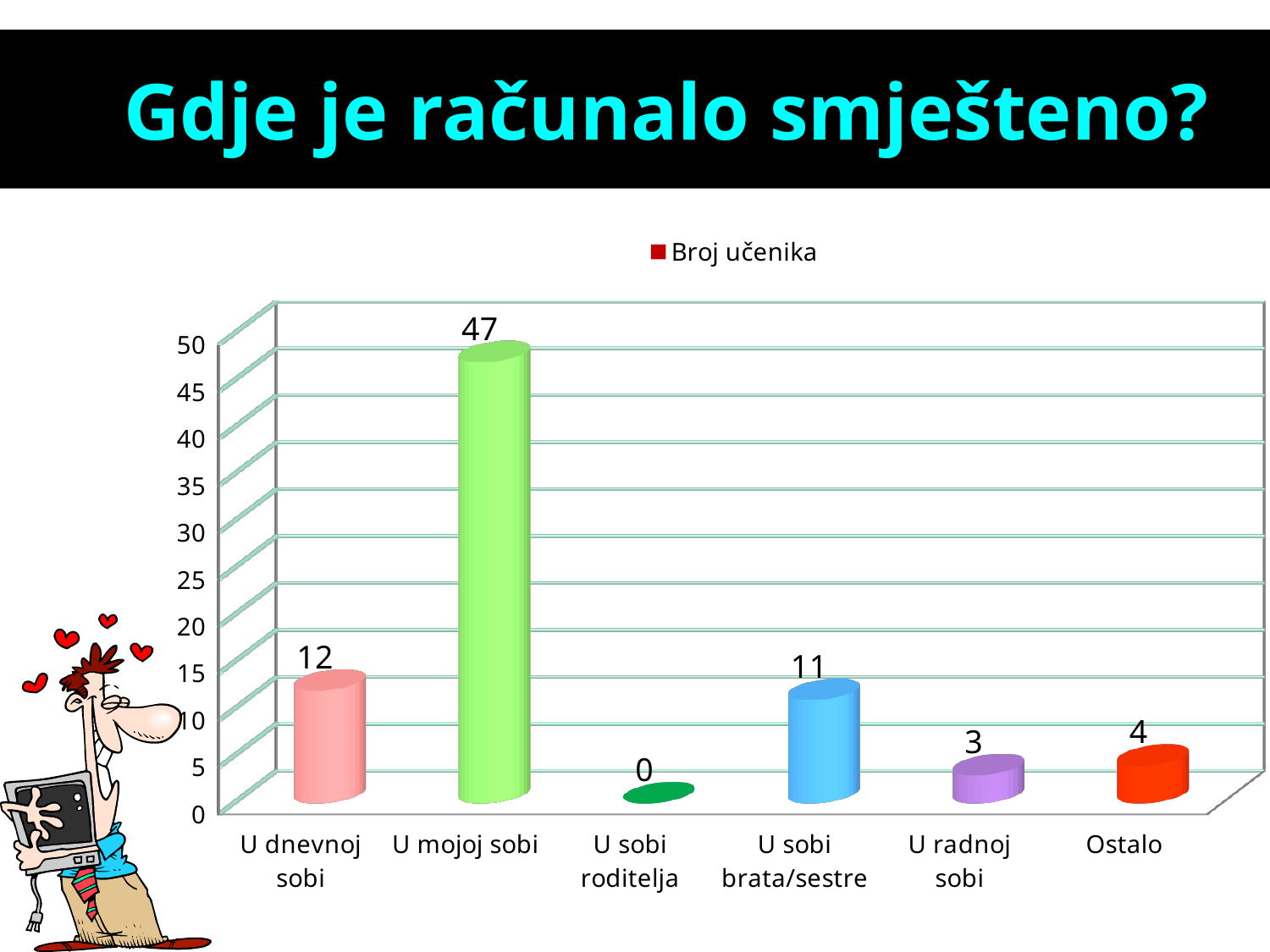
How many categories are shown on the x axis? 6 Which category has the lowest value? U sobi roditelja Which is larger, the value for U radnoj sobi or the value for Ostalo? Ostalo What is the value for Ostalo? 4 How many series does the legend list? 1 What is the difference between the values for U mojoj sobi and U dnevnoj sobi? 35 What is the value for U sobi brata/sestre? 11 What is the value for U dnevnoj sobi? 12 What kind of chart is shown on the slide? bar chart What is the name of the series shown in the legend? Broj učenika What is the value for U mojoj sobi? 47 Which category has the highest value? U mojoj sobi